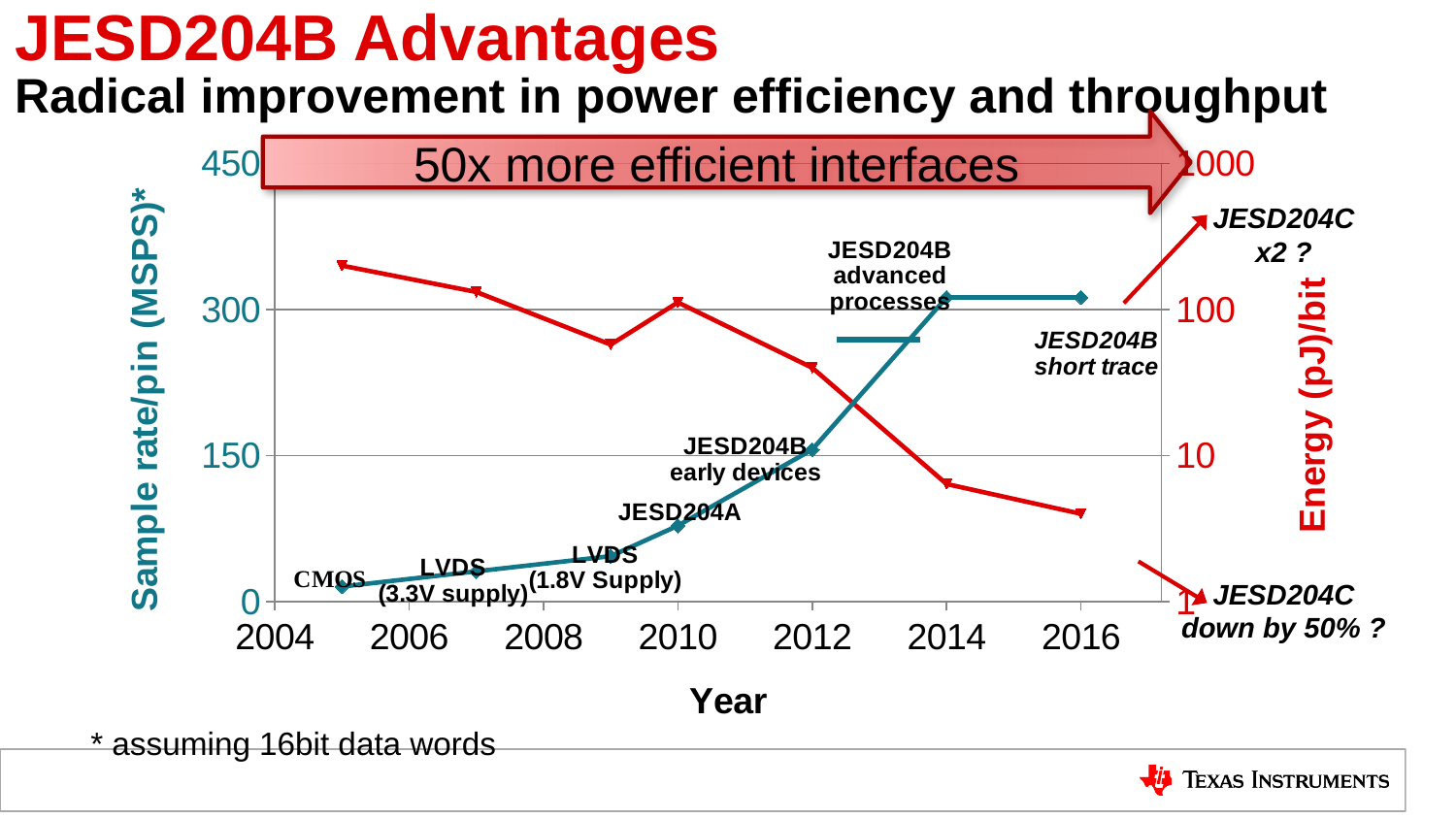
How does the Energy (pJ)/bit series change from 2004 to 2016? falls Which year has the lowest Sample rate/pin value? 2005 Is the Sample rate/pin value for 2010 greater or less than 150? less Which year has the lowest Energy (pJ)/bit value? 2016 Which is larger, the Sample rate/pin value for 2012 or for 2010? 2012 Is the Energy (pJ)/bit value for 2016 greater or less than 10? less How does the Sample rate/pin (MSPS) series change from 2004 to 2016? rises Is the Energy (pJ)/bit value for 2005 greater or less than 100? greater What is the title of the x axis? Year Which year has the highest Energy (pJ)/bit value? 2005 What kind of chart is shown on the slide? line chart